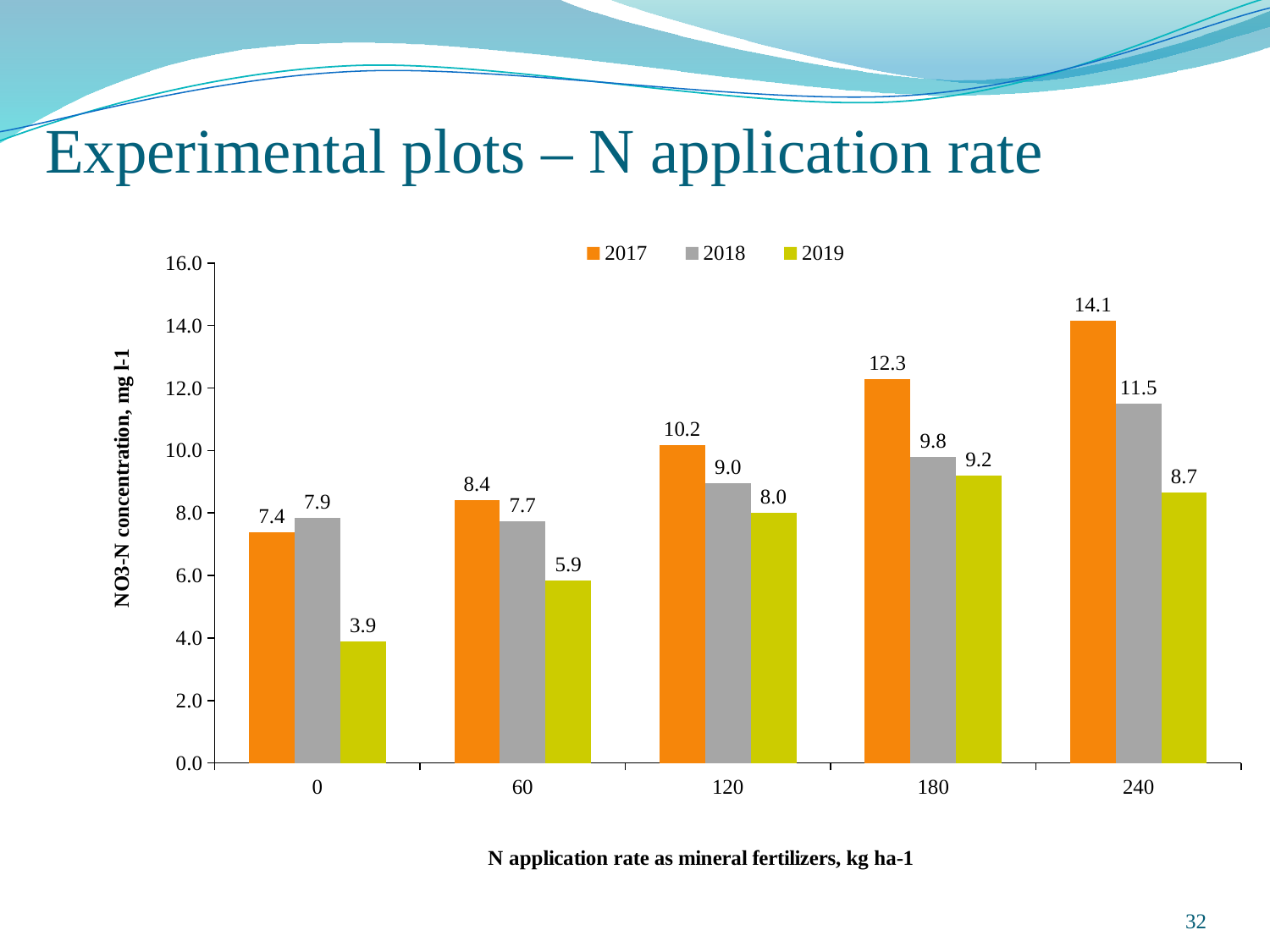
Is the value for 2018 at an N application rate of 180 greater or less than 10.0? less What is the NO3-N concentration for 2017 at an N application rate of 120? 10.2 Do the 2017 values rise or fall as the N application rate increases? rise Which N application rate has the highest NO3-N concentration for 2017? 240 What is the NO3-N concentration for 2018 at an N application rate of 240? 11.5 What is the difference between the 2017 and 2019 values at an N application rate of 240? 5.4 What kind of chart is shown on the slide? bar chart Which N application rate has the lowest NO3-N concentration for 2019? 0 How many N application rate categories are shown on the x axis? 5 What is the NO3-N concentration for 2019 at an N application rate of 0? 3.9 How many series does the legend list? 3 At an N application rate of 0, which series has the larger value, 2017 or 2018? 2018